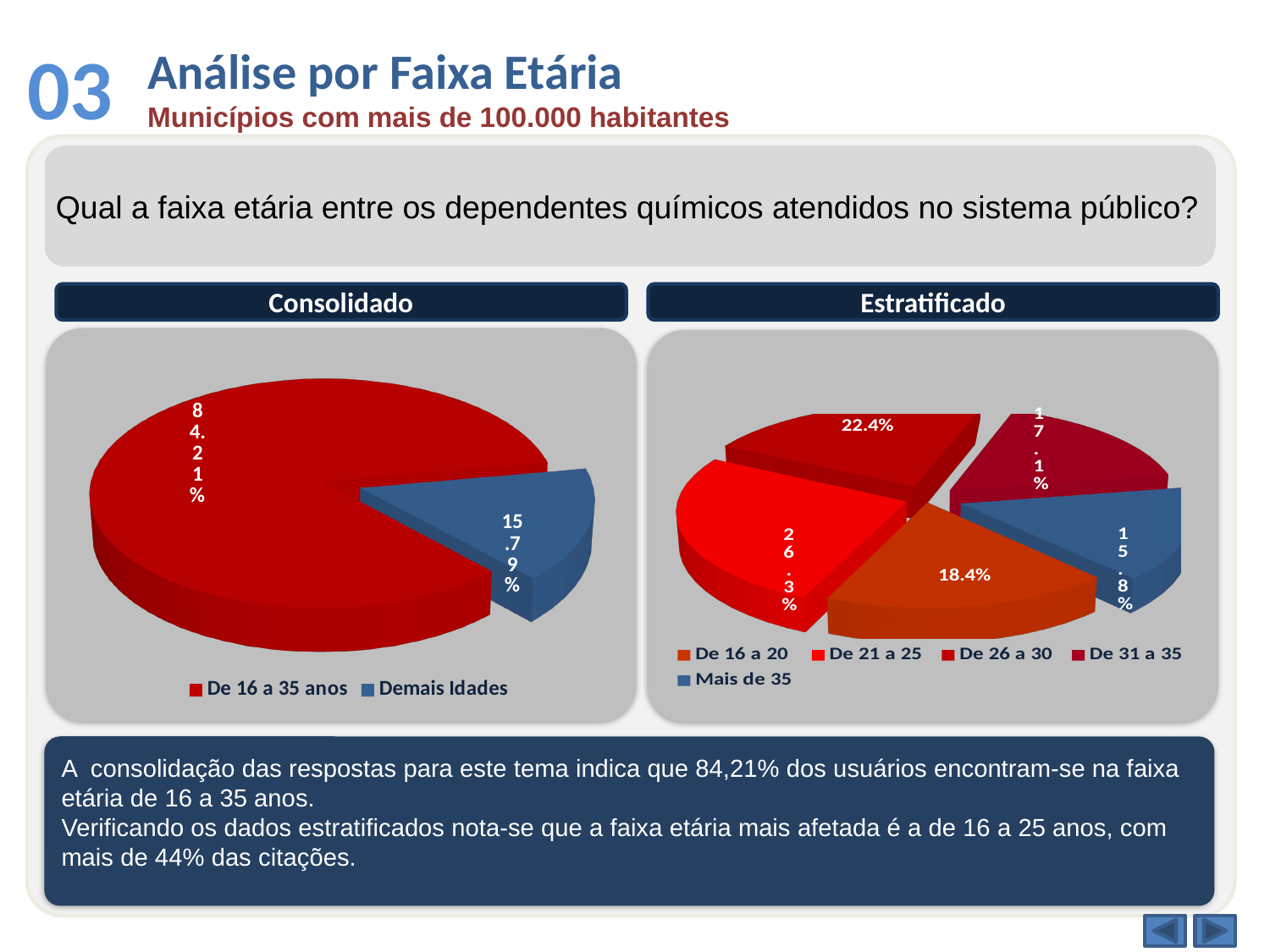
In the Estratificado chart, what percentage is shown for De 21 a 25? 26.3% In the Estratificado chart, which is larger: De 26 a 30 or De 31 a 35? De 26 a 30 In the Consolidado chart, what percentage is shown for Demais Idades? 15.79% In the Consolidado chart, what is the difference between the De 16 a 35 anos and Demais Idades shares? 68.42% In the Consolidado chart, what percentage is shown for De 16 a 35 anos? 84.21% In the Estratificado chart, what percentage is shown for De 16 a 20? 18.4% In the Estratificado chart, which age group has the largest share? De 21 a 25 In the Estratificado chart, which age group has the smallest share? Mais de 35 In the Estratificado chart, how many categories does the legend list? 5 In the Estratificado chart, what percentage is shown for Mais de 35? 15.8% In the Consolidado chart, which category has the largest share? De 16 a 35 anos What kind of chart is the Estratificado chart? Pie chart